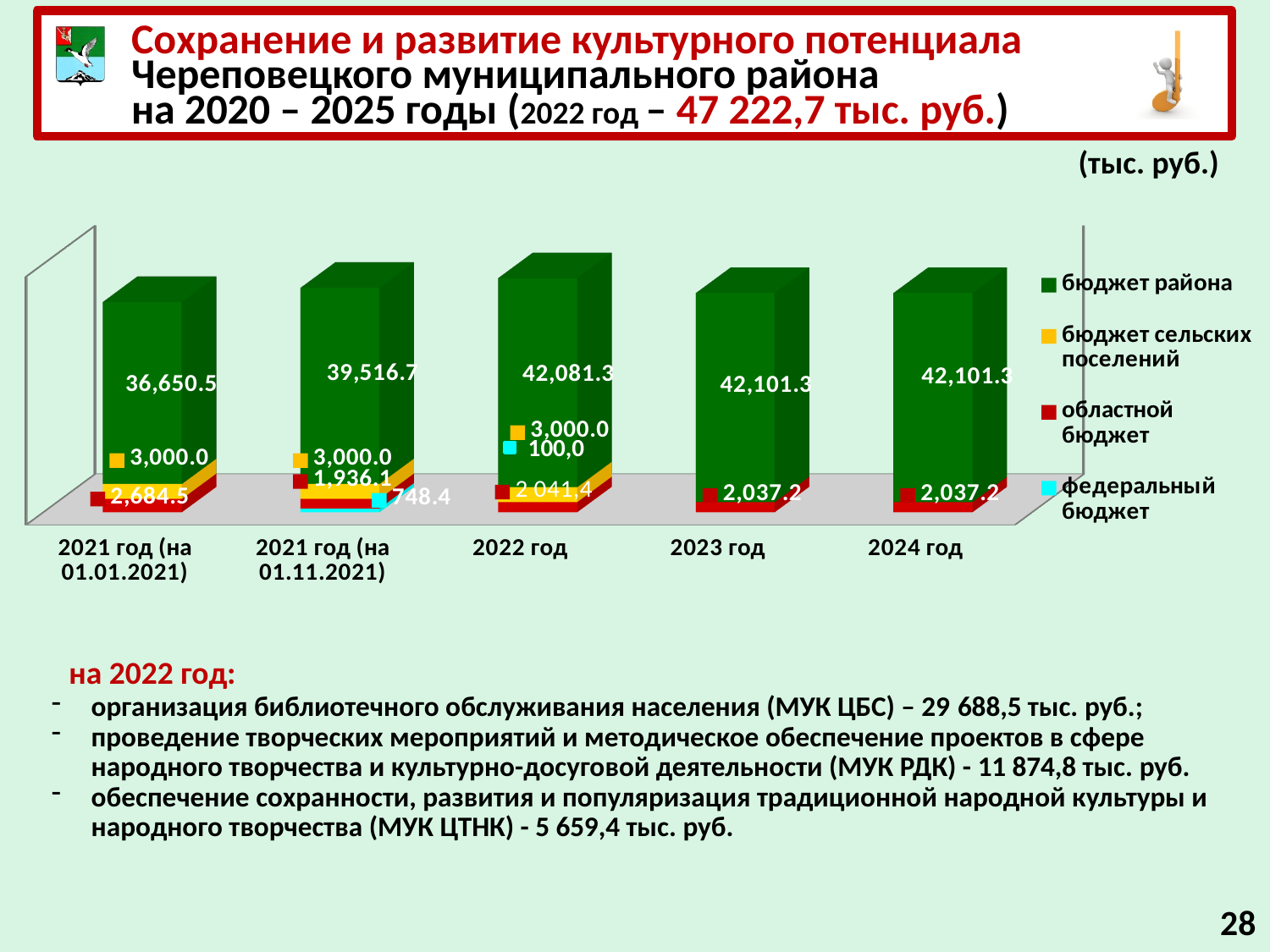
What is the value of областной бюджет for 2021 год (на 01.01.2021)? 2,684.5 How many series does the legend list? 4 What is the difference in бюджет района between 2021 год (на 01.11.2021) and 2021 год (на 01.01.2021)? 2,866.2 Which is larger for областной бюджет: 2021 год (на 01.01.2021) or 2022 год? 2021 год (на 01.01.2021) What is the total of the stacked bar for 2022 год? 47,222.7 What is the value of областной бюджет for 2024 год? 2,037.2 What is the value of бюджет района for 2022 год? 42,081.3 What is the value of федеральный бюджет for 2021 год (на 01.11.2021)? 748.4 What kind of chart is shown on the slide? Stacked bar chart What is the value of федеральный бюджет for 2022 год? 100,0 Which category has the lowest value for бюджет района? 2021 год (на 01.01.2021) How many categories are shown on the x axis of the chart? 5